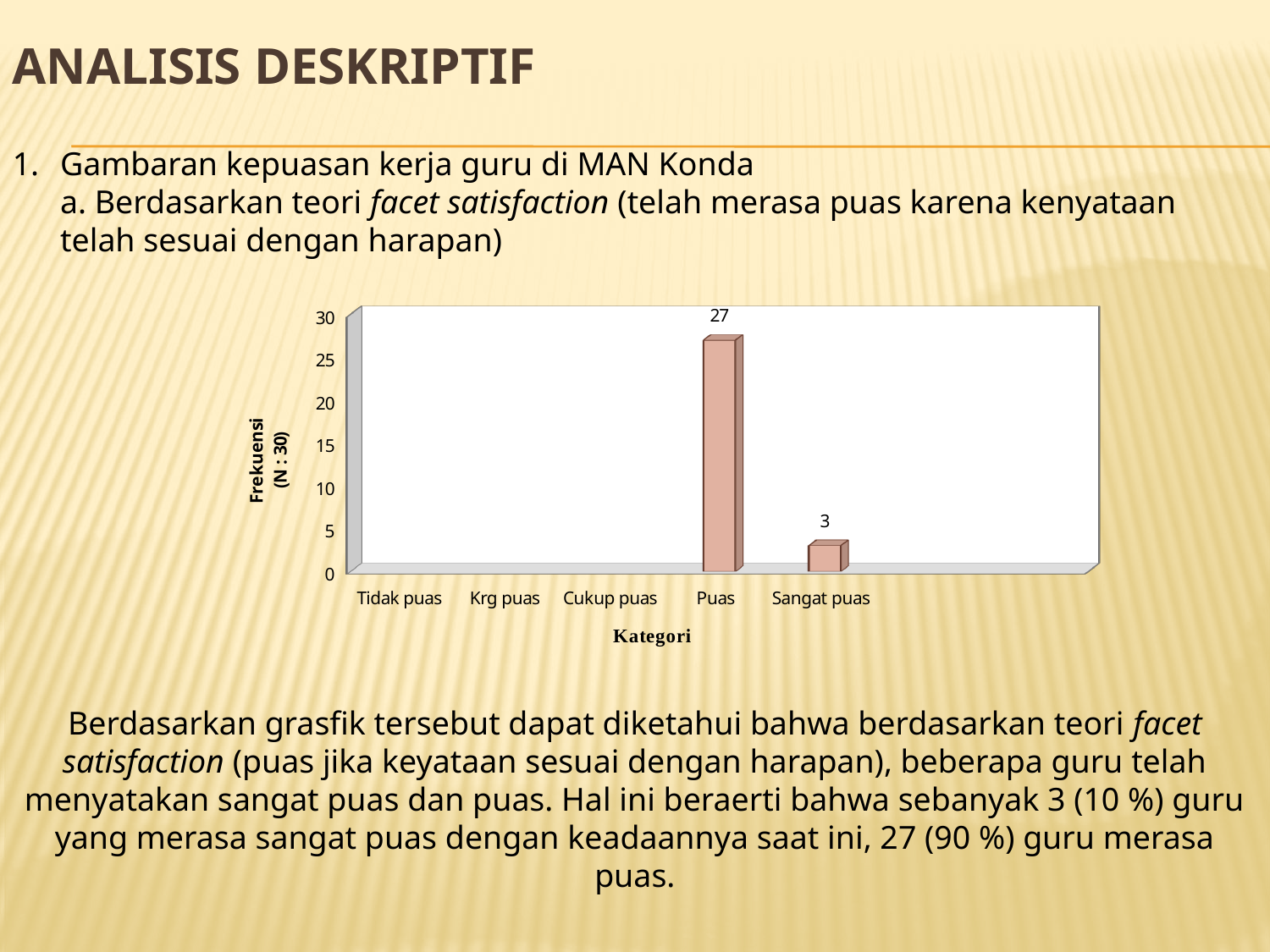
What is the title of the y axis? Frekuensi (N : 30) What is the difference between the values for Puas and Sangat puas? 24 Which is larger, the value for Puas or the value for Sangat puas? Puas What is the value for Puas? 27 What is the title of the x axis? Kategori Which category has the highest value? Puas Is the value for Sangat puas greater or less than 5? less What kind of chart is shown on the slide? bar chart How many categories are shown on the x axis? 5 What is the value for Sangat puas? 3 Is the value for Puas greater or less than 20? greater